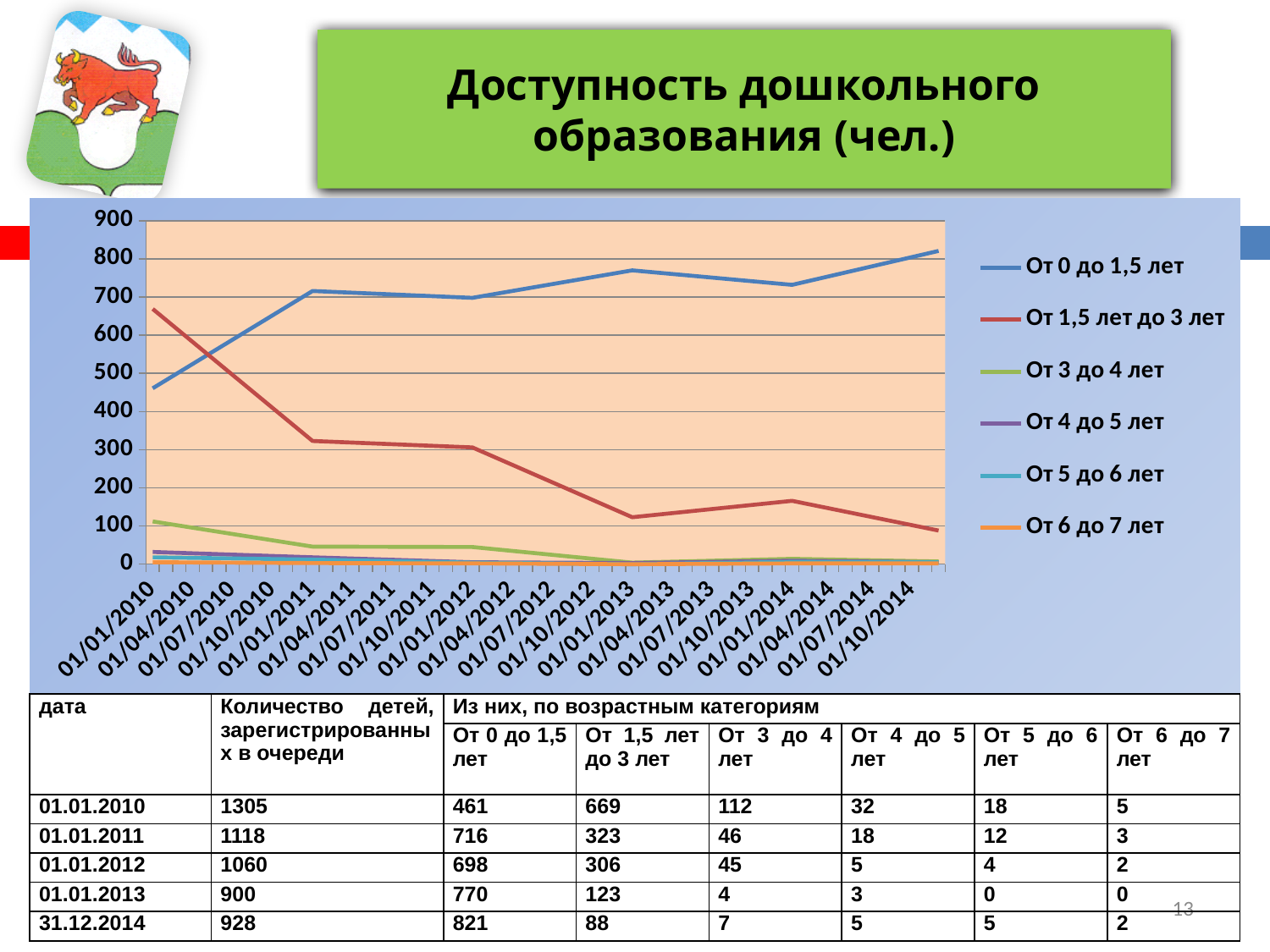
How many series does the chart legend list? 6 At 01/01/2010, which is larger: "От 0 до 1,5 лет" or "От 1,5 лет до 3 лет"? От 1,5 лет до 3 лет Does the line for "От 1,5 лет до 3 лет" generally rise or fall from 01/01/2010 to 01/10/2014? fall Is the value for "От 0 до 1,5 лет" at 01/01/2010 greater or less than 500? less Which series has the highest value at 01/10/2014? От 0 до 1,5 лет According to the table under the chart, what is the value for "От 0 до 1,5 лет" on 01.01.2013? 770 What is the title of the chart on the slide? Доступность дошкольного образования (чел.) What kind of chart is shown on the slide? line chart How many dates are shown along the x axis of the chart? 20 Is the value for "От 1,5 лет до 3 лет" at 01/01/2010 greater or less than 600? greater According to the table under the chart, what is the difference between "От 0 до 1,5 лет" and "От 1,5 лет до 3 лет" on 01.01.2013? 647 Does the line for "От 0 до 1,5 лет" generally rise or fall from 01/01/2010 to 01/10/2014? rise